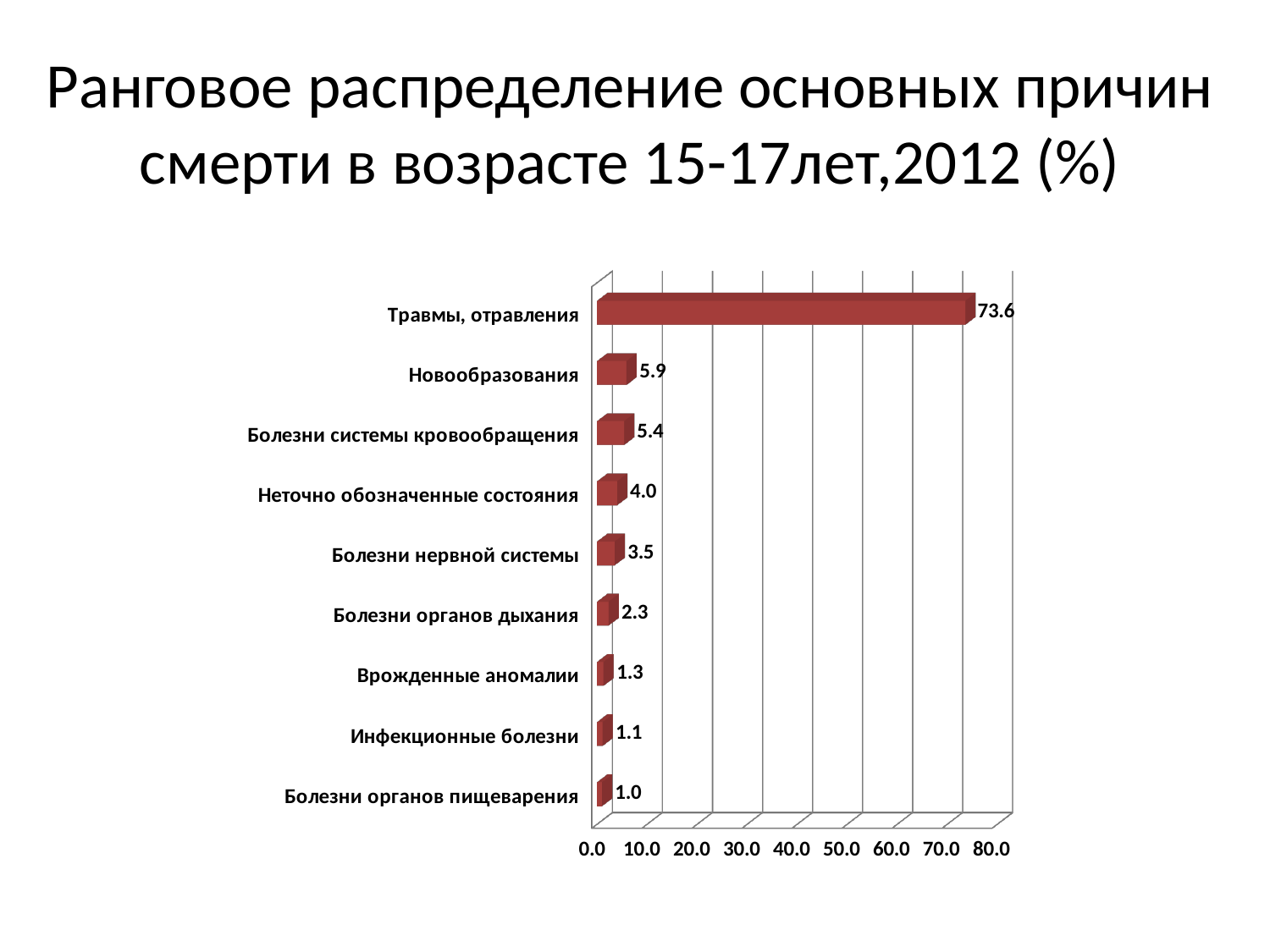
What kind of chart is shown on the slide? bar chart Which category has the highest value? Травмы, отравления Which is larger, the value for Болезни органов дыхания or the value for Врожденные аномалии? Болезни органов дыхания What is the value for Болезни нервной системы? 3.5 What is the difference between the values for Болезни системы кровообращения and Неточно обозначенные состояния? 1.4 What is the value for Новообразования? 5.9 Is the value for Травмы, отравления greater or less than 70.0? greater What is the maximum value shown on the horizontal axis? 80.0 How many categories are shown in the chart? 9 Which category has the lowest value? Болезни органов пищеварения What is the value for Травмы, отравления? 73.6 What is the difference between the values for Травмы, отравления and Новообразования? 67.7